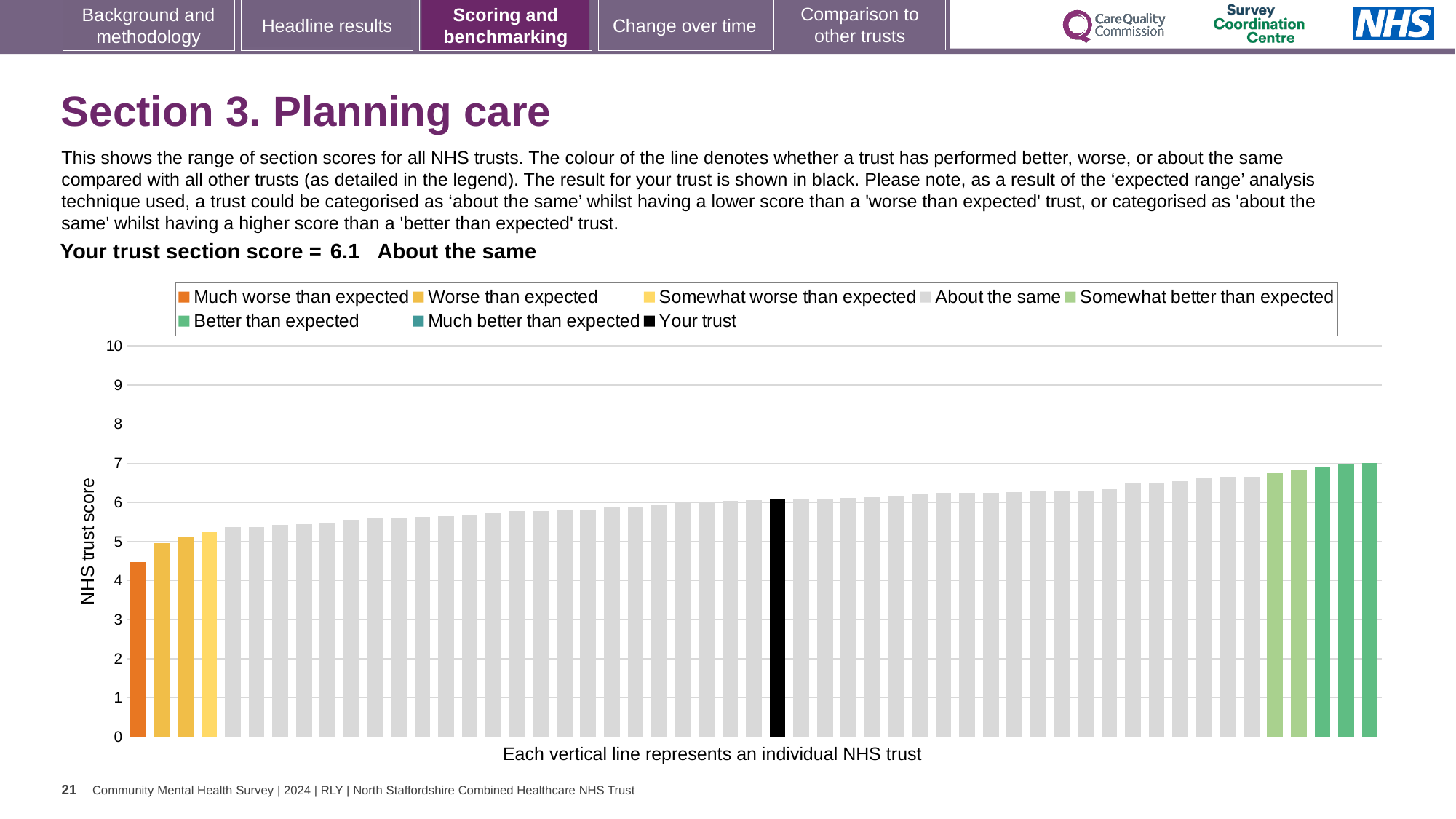
What kind of chart is shown on the slide? bar chart What colour is the bar representing your trust? black What is the section score for your trust shown on the slide? 6.1 How is your trust's section score categorised compared with other trusts? About the same How many trusts are shown as 'Better than expected' (dark green bars)? 3 How many trusts are shown as 'Much worse than expected' (orange bars)? 1 How many entries does the chart legend list? 8 Is the value of the highest-scoring trust (the rightmost bar) greater or less than 6? greater Is the value for your trust (the black bar) greater or less than 5? greater Do the trust scores rise or fall from left to right along the x axis? rise Is the value of the lowest-scoring trust (the orange bar) greater or less than 5? less Which legend category does the highest-scoring trust belong to? Better than expected